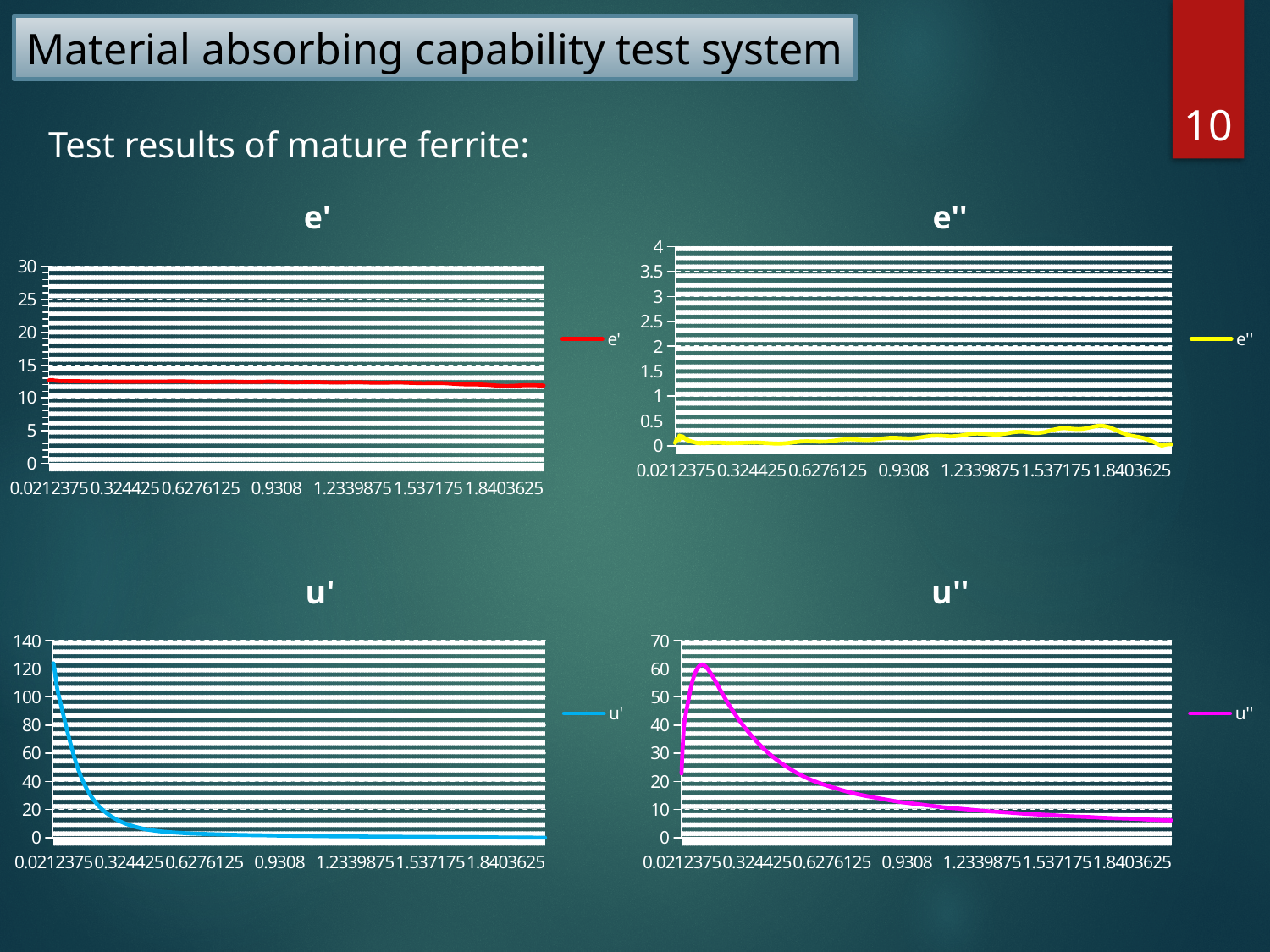
In the chart titled u', is the value for u' at 1.8403625 greater or less than 20? less In the chart titled u'', is the value for u'' at 1.8403625 greater or less than 20? less In the chart titled u', is the value for u' at 0.0212375 greater or less than 100? greater What colour is the line in the chart titled e''? yellow In the chart titled u', do the values rise or fall along the x axis? fall What is the title of the bottom-left chart? u' How many series does the legend of the chart titled u'' list? 1 What kind of chart is the chart titled e'? line chart